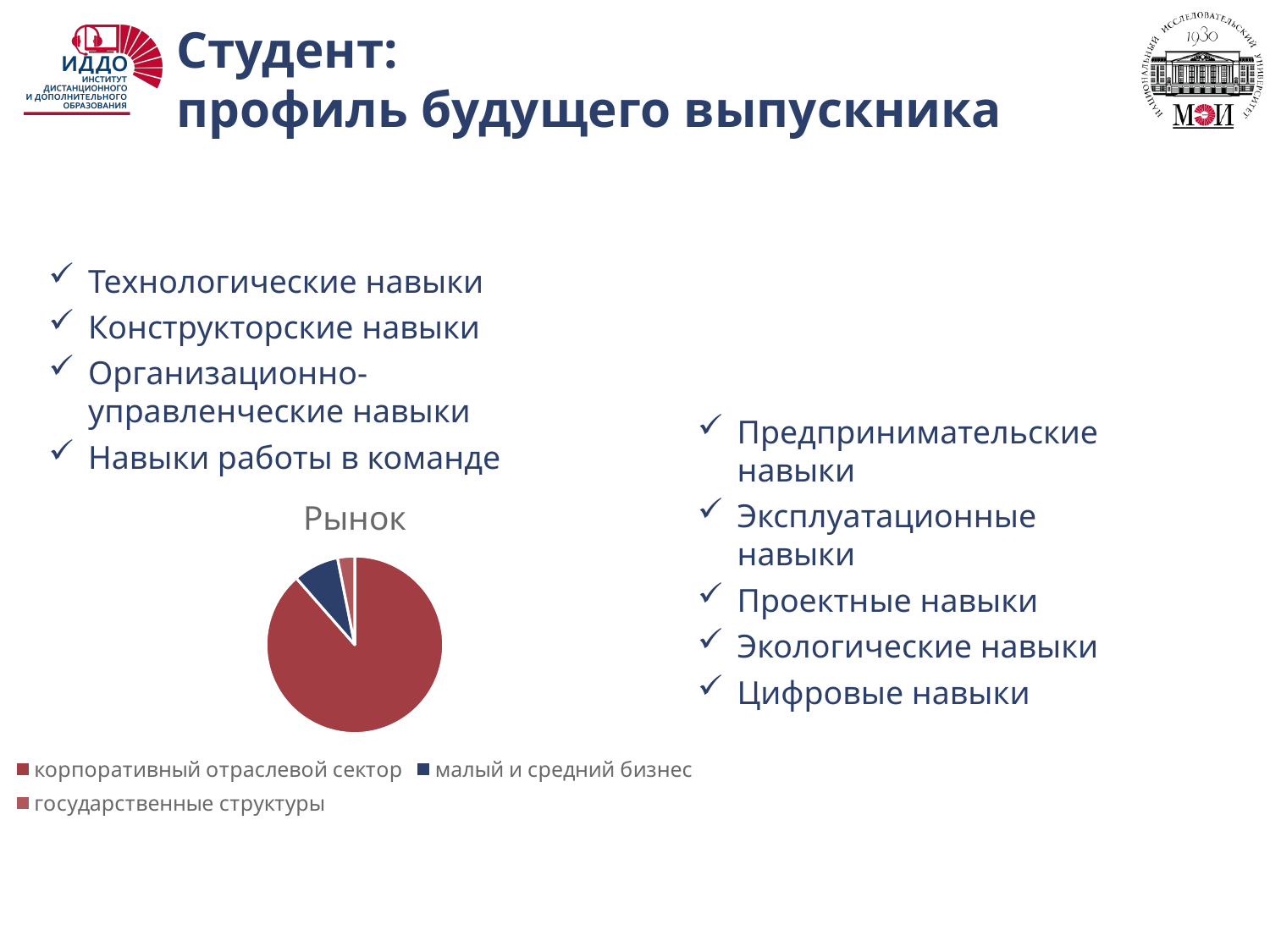
Which slice is larger: малый и средний бизнес or государственные структуры? малый и средний бизнес How many slices does the pie chart have? 3 What kind of chart is shown on the slide? pie chart Which category has the smallest slice in the pie chart? государственные структуры Which category has the largest slice in the pie chart? корпоративный отраслевой сектор What is the title of the pie chart? Рынок How many entries does the legend of the pie chart list? 3 Which legend entry is shown in dark blue in the pie chart? малый и средний бизнес Which slice is larger: корпоративный отраслевой сектор or малый и средний бизнес? корпоративный отраслевой сектор